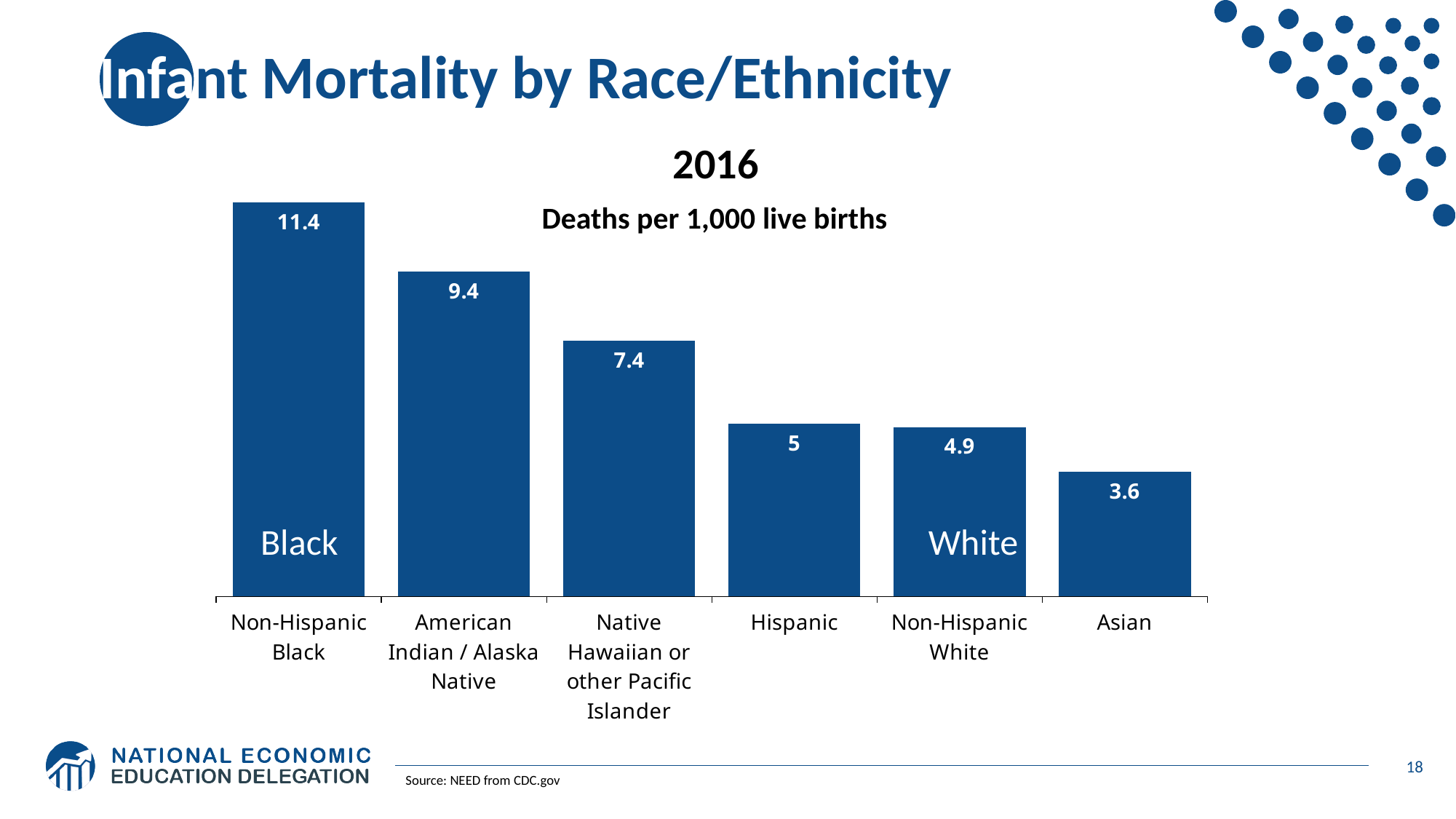
What kind of chart is shown on the slide? Bar chart What is the infant mortality rate for Hispanic? 5 What is the infant mortality rate for Non-Hispanic Black? 11.4 What is the infant mortality rate for Asian? 3.6 How many race/ethnicity categories are shown in the chart? 6 What is the infant mortality rate for Native Hawaiian or other Pacific Islander? 7.4 What is the infant mortality rate for American Indian / Alaska Native? 9.4 What unit is the infant mortality rate measured in, according to the chart subtitle? Deaths per 1,000 live births Which race/ethnicity has the highest infant mortality rate? Non-Hispanic Black What is the difference between the infant mortality rates for Non-Hispanic Black and Non-Hispanic White? 6.5 Which has a higher infant mortality rate, Hispanic or Non-Hispanic White? Hispanic Which race/ethnicity has the lowest infant mortality rate? Asian